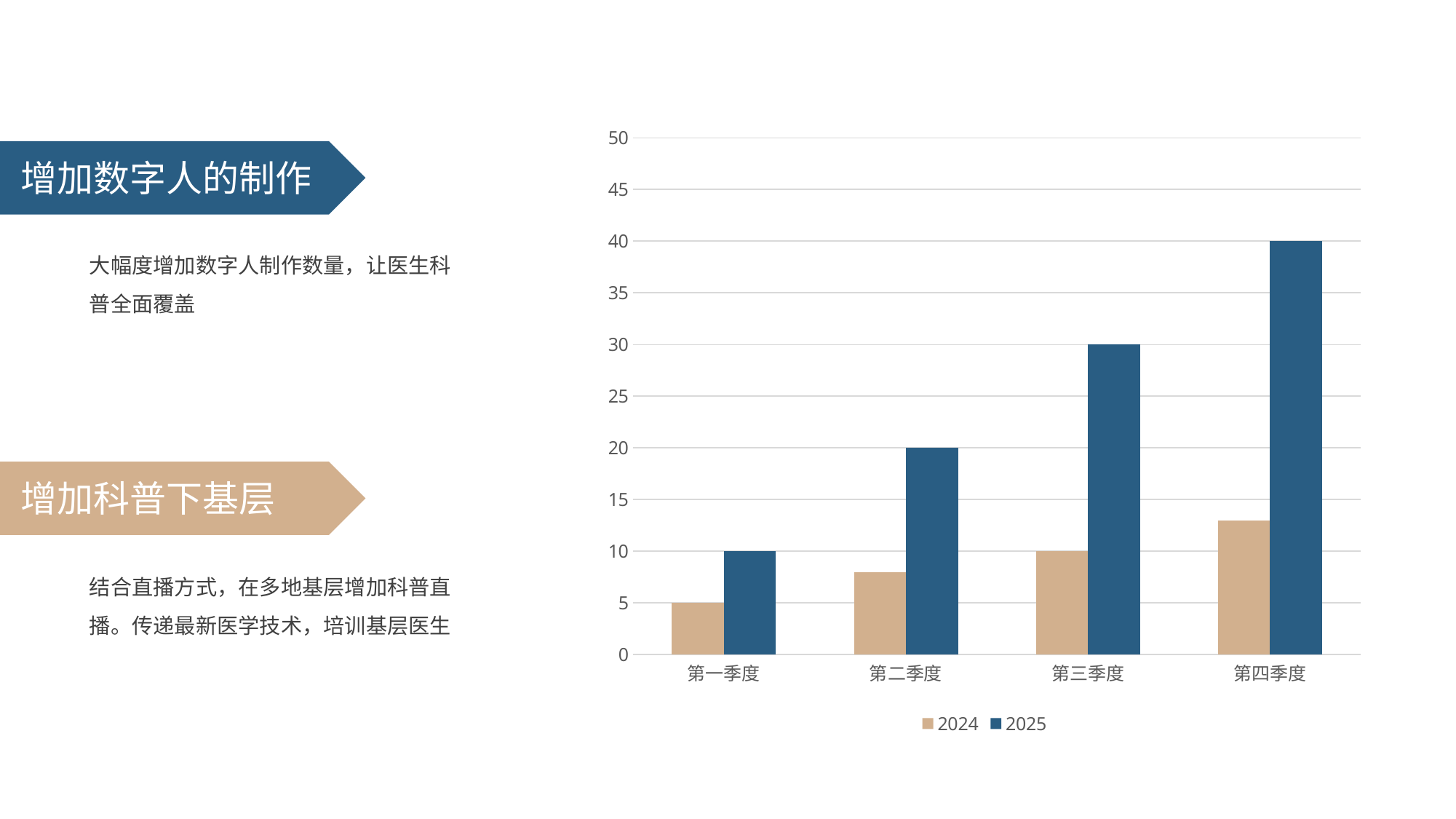
Which quarter has the lowest value for the 2024 series? 第一季度 How many series does the legend list? 2 What is the difference between the 2025 values for 第四季度 and 第三季度? 10 Which quarter has the highest value for the 2025 series? 第四季度 What is the value for 2024 in 第一季度? 5 Do the 2025 values rise or fall from 第一季度 to 第四季度? rise Is the value for 2024 in 第二季度 greater or less than 10? less How many categories are shown on the x axis? 4 Which is larger in 第三季度, the 2024 value or the 2025 value? 2025 What kind of chart is shown on the slide? bar chart What is the value for 2025 in 第四季度? 40 What is the value for 2025 in 第二季度? 20